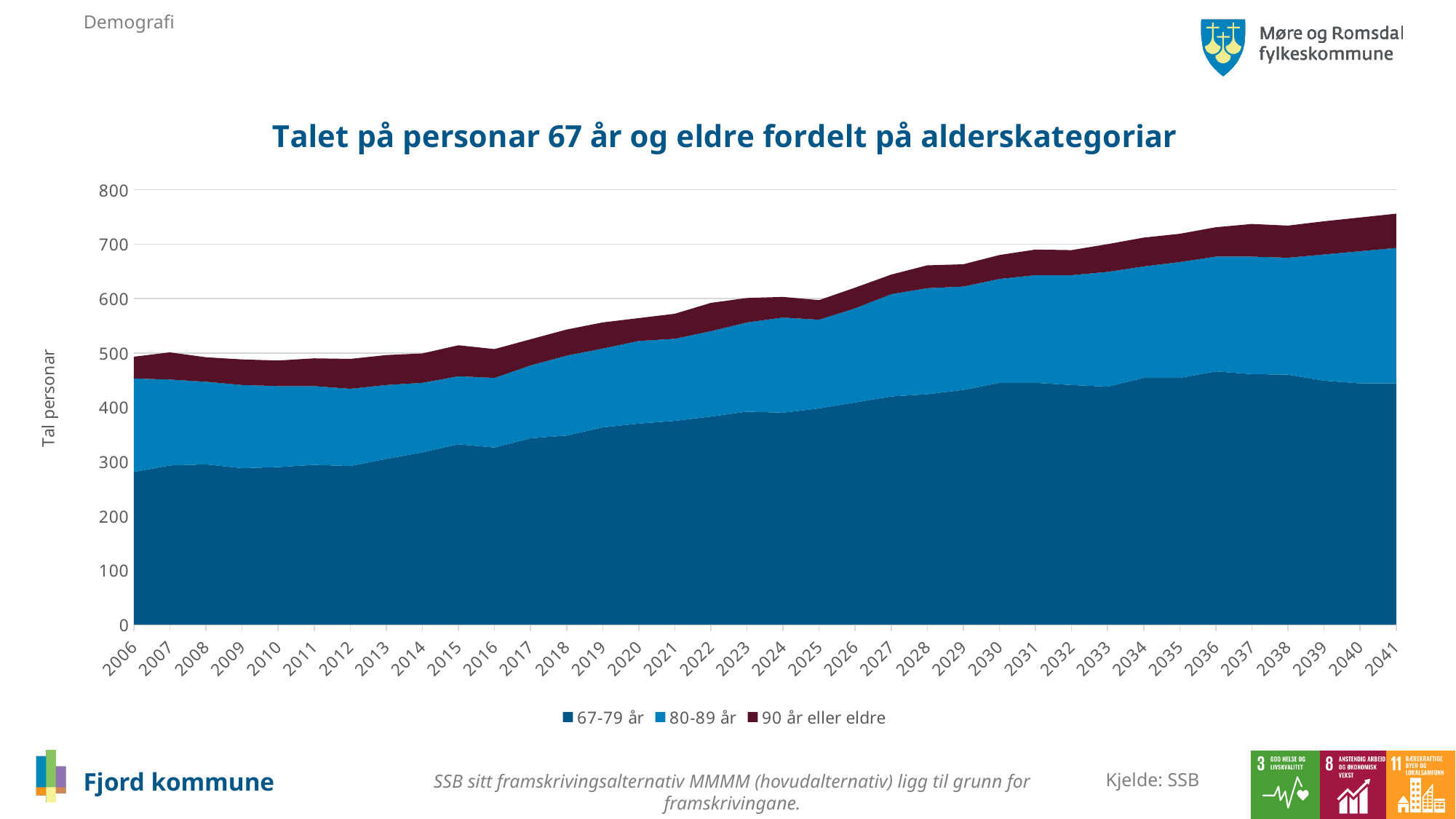
What kind of chart is shown on the slide? Stacked area chart Is the value for 67-79 år in 2020 greater or less than 400? less Is the total value for 2041 greater or less than 700? greater What is the title of the chart? Talet på personar 67 år og eldre fordelt på alderskategoriar What is the label on the y axis? Tal personar Is the total value for 2030 greater or less than 600? greater How many years are shown along the x axis? 36 Does the total number of persons 67 years and older rise or fall from 2006 to 2041? Rise How many series does the legend list? 3 Which age category has the largest share of the total in 2041? 67-79 år